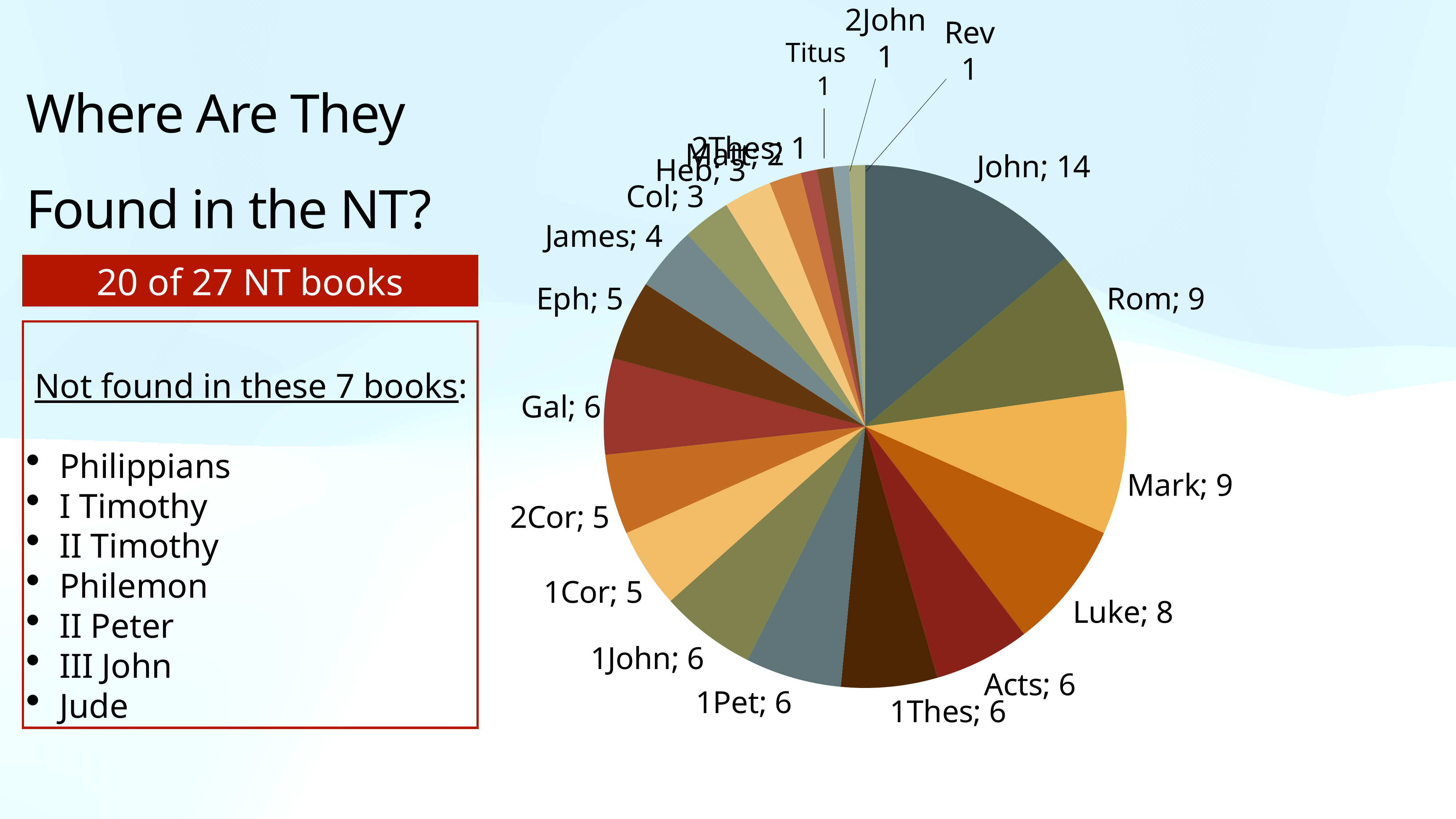
What is the value for Col in the pie chart? 3 What is the difference between the values for Luke and Acts? 2 Which book has the largest slice in the pie chart? John What is the value for Luke in the pie chart? 8 What is the value for Rom in the pie chart? 9 What is the difference between the values for John and Rom? 5 Which has the larger value, Luke or Eph? Luke What is the value for John in the pie chart? 14 What kind of chart is shown on the slide? pie chart How many slices does the pie chart have? 20 What is the value for James in the pie chart? 4 What is the value for Titus in the pie chart? 1